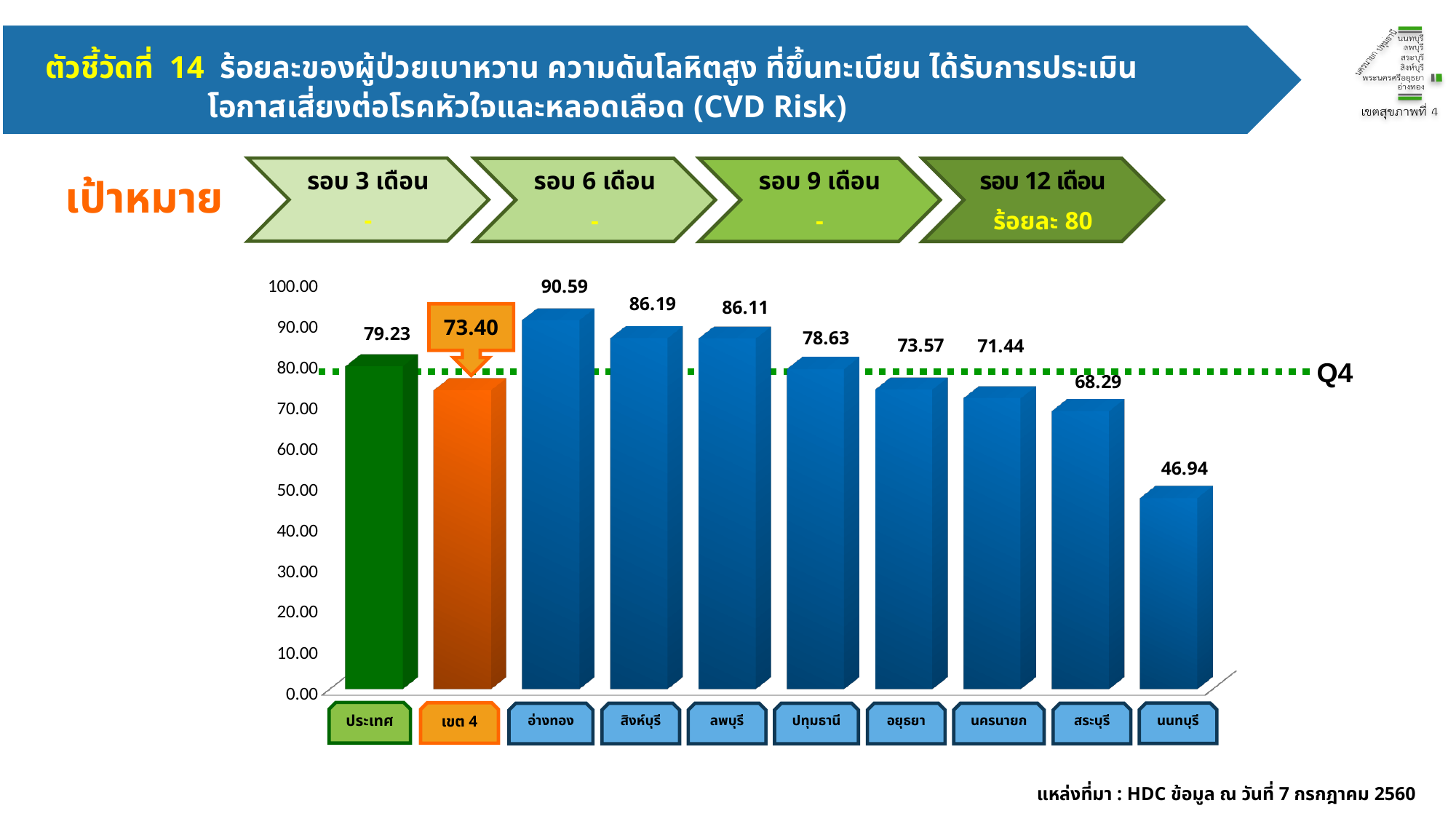
How many categories are shown on the x axis? 10 What is the value for เขต 4? 73.40 What is the value for ประเทศ? 79.23 Which category has the highest value? อ่างทอง Which category has the lowest value? นนทบุรี Is the value for สระบุรี greater or less than 80? less What kind of chart is shown on the slide? bar chart What is the value for นนทบุรี? 46.94 Which is larger, the value for ปทุมธานี or the value for อยุธยา? ปทุมธานี What is the value for อ่างทอง? 90.59 What is the difference between the values for ประเทศ and เขต 4? 5.83 What is the difference between the values for อ่างทอง and นนทบุรี? 43.65